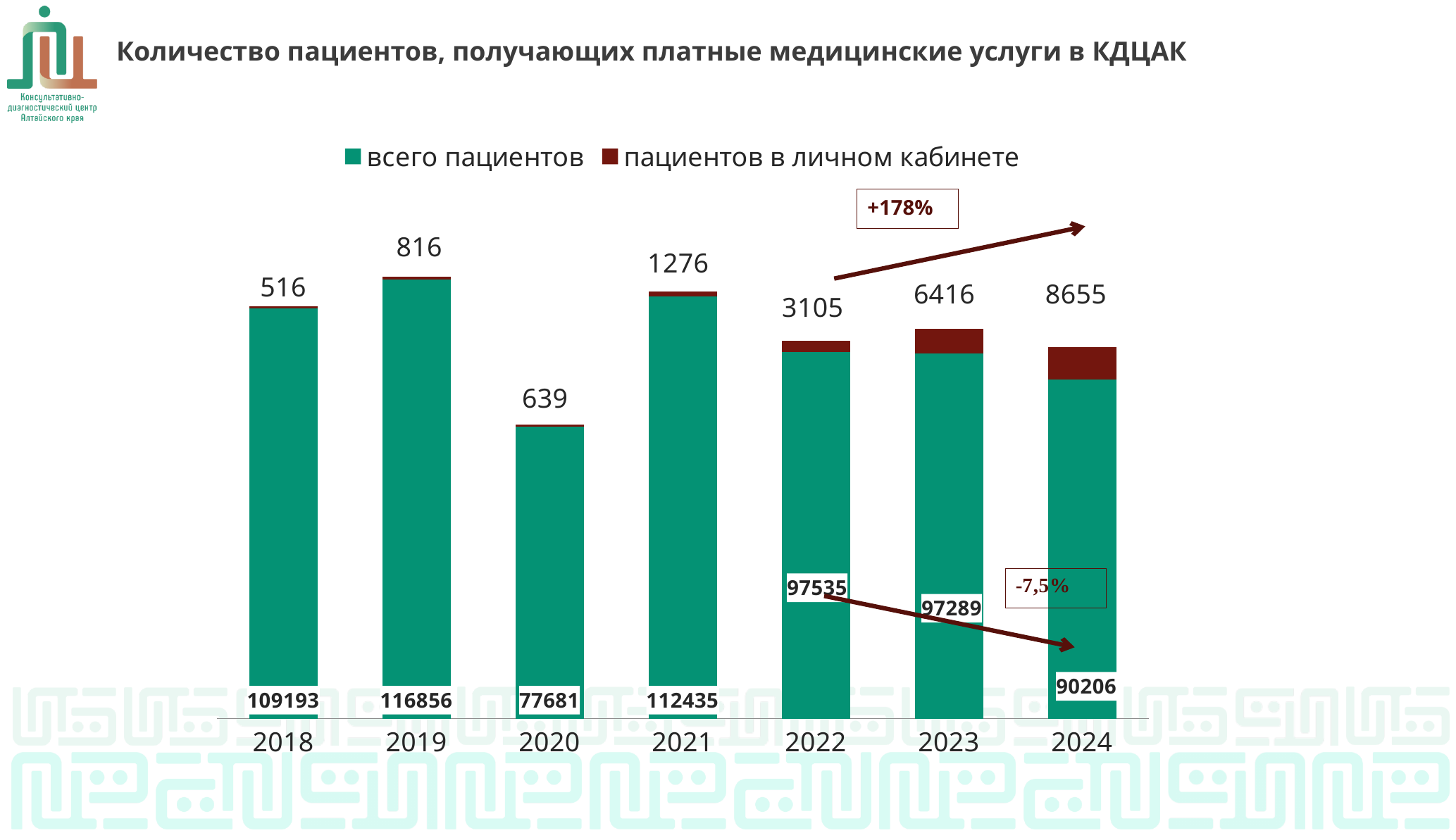
Which year has the lowest value for "пациентов в личном кабинете"? 2018 What is the total height of the stacked bar for 2024 (both series combined)? 98861 How many series does the legend list? 2 What is the difference between the "пациентов в личном кабинете" values for 2024 and 2023? 2239 What is the value of "всего пациентов" for 2020? 77681 Which year has the highest value for "всего пациентов"? 2019 How many years are shown on the x axis? 7 What is the value of "пациентов в личном кабинете" for 2023? 6416 What type of chart is shown on the slide? bar chart Do the "пациентов в личном кабинете" values rise or fall from 2020 to 2024? rise Which is larger, the "всего пациентов" value for 2021 or for 2022? 2021 What percentage change is shown in the box above the upward arrow? +178%